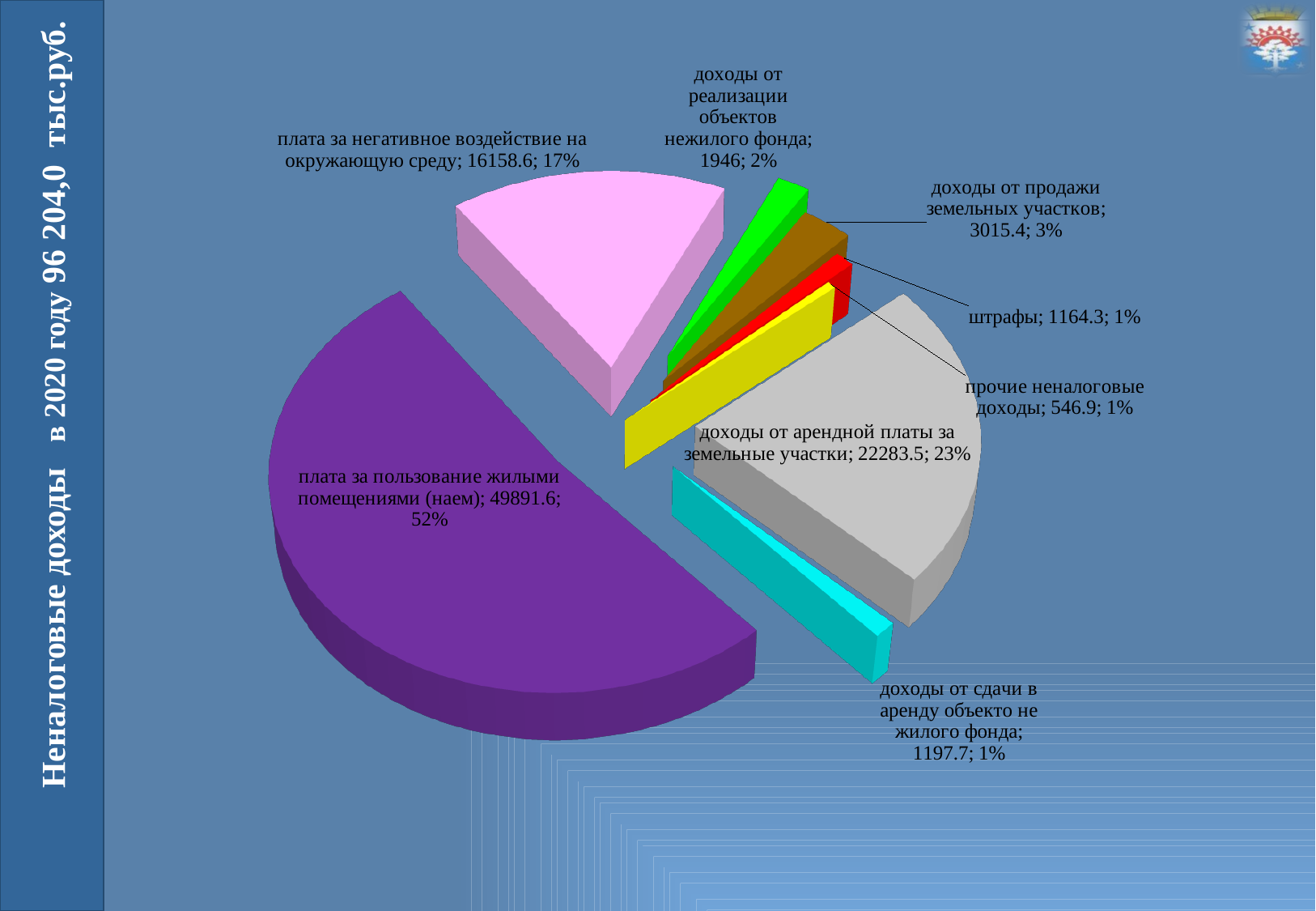
What total amount of non-tax revenue for 2020 is stated in the slide title? 96 204,0 тыс.руб. Which is larger: the value for «доходы от реализации объектов нежилого фонда» or the value for «доходы от сдачи в аренду объекто не жилого фонда»? доходы от реализации объектов нежилого фонда What share of the pie does «плата за негативное воздействие на окружающую среду» represent? 17% What is the value for «доходы от арендной платы за земельные участки»? 22283.5 Which category has the smallest slice of the pie? прочие неналоговые доходы What is the value for «штрафы»? 1164.3 What share of the pie does «доходы от продажи земельных участков» represent? 3% How many slices does the pie chart have? 8 Which category has the largest slice of the pie? плата за пользование жилыми помещениями (наем) What kind of chart is shown on the slide? pie chart What is the difference between the values for «доходы от арендной платы за земельные участки» and «плата за негативное воздействие на окружающую среду»? 6124.9 What is the value for «плата за пользование жилыми помещениями (наем)»? 49891.6